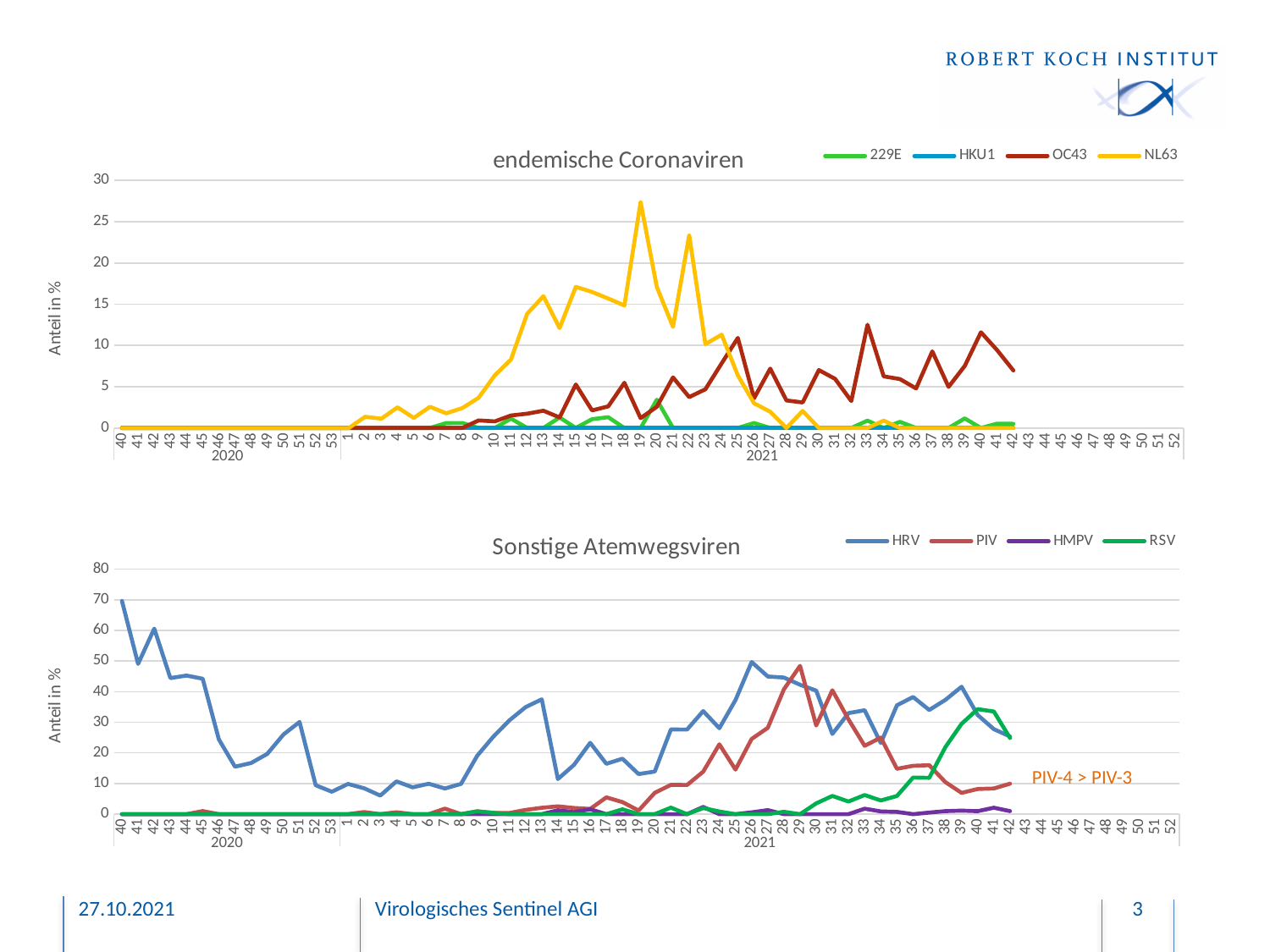
In the top chart "endemische Coronaviren", which series reaches the highest value? NL63 How many series does the legend of the bottom chart "Sonstige Atemwegsviren" list? 4 What annotation text is printed in orange inside the bottom chart "Sonstige Atemwegsviren"? PIV-4 > PIV-3 In the bottom chart "Sonstige Atemwegsviren", is the value for PIV at week 29 of 2021 greater or less than 40? greater How many series does the legend of the top chart "endemische Coronaviren" list? 4 In the top chart "endemische Coronaviren", is the value for OC43 at week 33 of 2021 greater or less than 10? greater In the top chart "endemische Coronaviren", is the value for NL63 at week 19 of 2021 greater or less than 25? greater In the bottom chart "Sonstige Atemwegsviren", which is larger at week 40 of 2020, HRV or RSV? HRV In the bottom chart "Sonstige Atemwegsviren", does the HRV line rise or fall from week 40 to week 47 of 2020? fall What is the title of the bottom chart on the slide? Sonstige Atemwegsviren What kind of chart is the top chart titled "endemische Coronaviren"? line chart